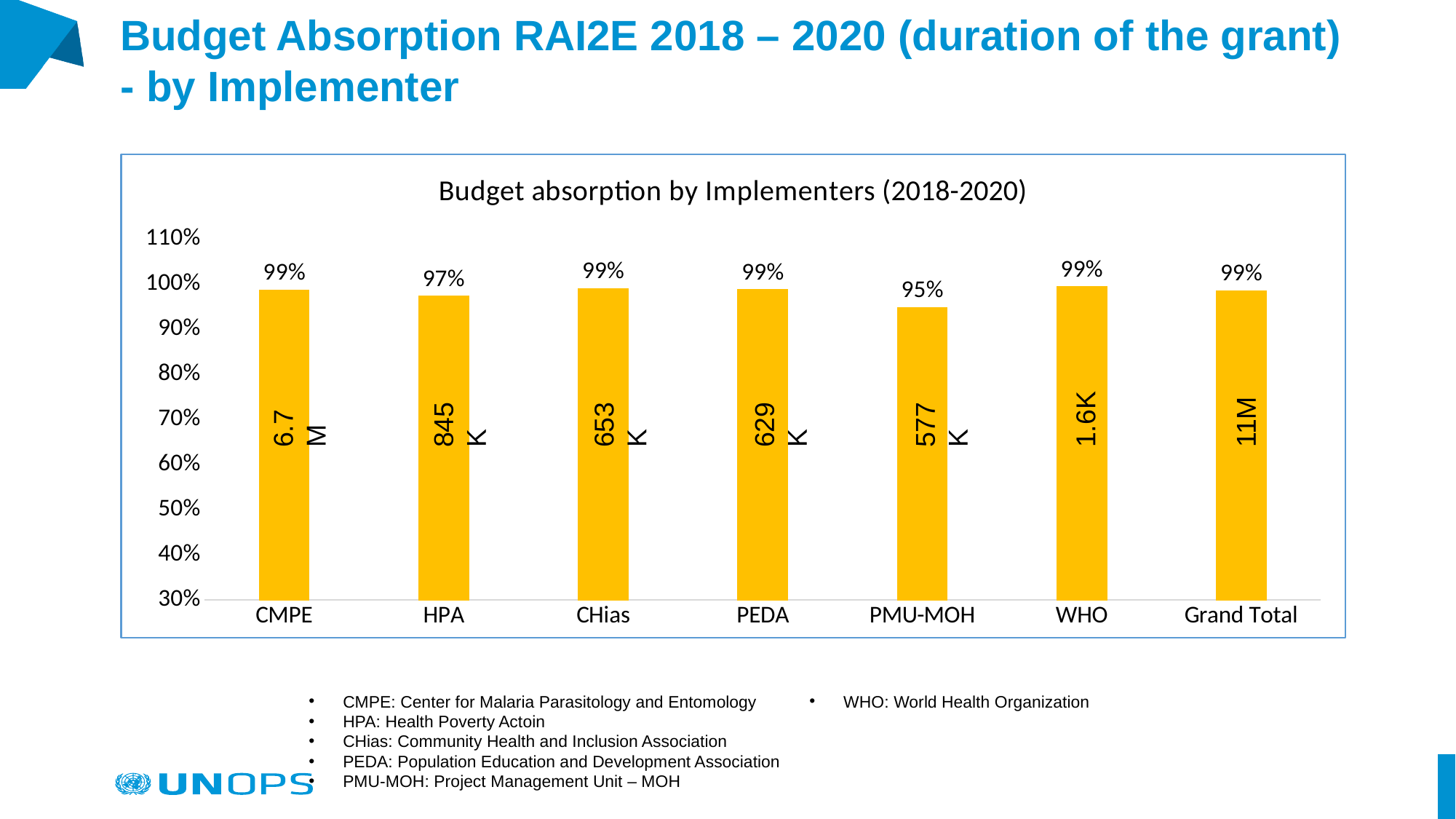
How many bars are shown in the chart? 7 What amount label is shown inside the bar for WHO? 1.6K Which implementer has the lowest budget absorption percentage? PMU-MOH What amount label is shown inside the bar for CMPE? 6.7 M Is the budget absorption value for PMU-MOH greater or less than 90%? greater What is the budget absorption percentage for the Grand Total? 99% What is the budget absorption percentage for HPA? 97% What is the difference in budget absorption percentage between CMPE and PMU-MOH? 4% What is the title of the chart? Budget absorption by Implementers (2018-2020) What is the budget absorption percentage for PMU-MOH? 95% Which has a higher budget absorption percentage, HPA or PEDA? PEDA What type of chart is shown on the slide? Bar chart